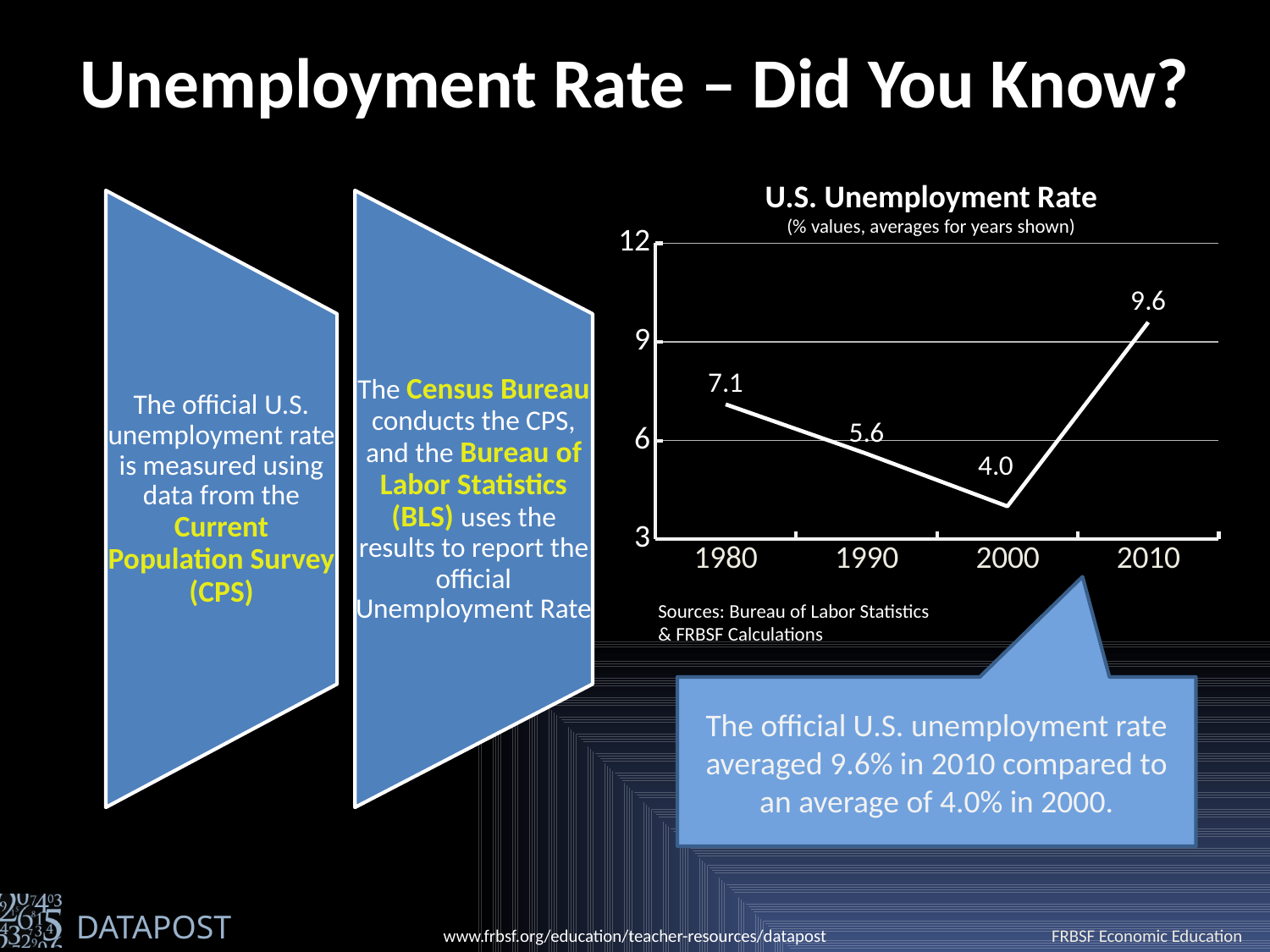
Is the unemployment rate for 2010 greater or less than 9? greater Which year has the lowest unemployment rate in the chart? 2000 What is the U.S. unemployment rate shown for 2000? 4.0 What is the title of the chart? U.S. Unemployment Rate Does the unemployment rate rise or fall from 1980 to 2000? fall How many years are plotted in the chart? 4 Which year has the highest unemployment rate in the chart? 2010 What is the difference between the unemployment rate in 2010 and in 2000? 5.6 What is the U.S. unemployment rate shown for 1980? 7.1 Which year has a higher unemployment rate, 1980 or 1990? 1980 What kind of chart is used to show the U.S. Unemployment Rate? line chart What is the U.S. unemployment rate shown for 2010? 9.6